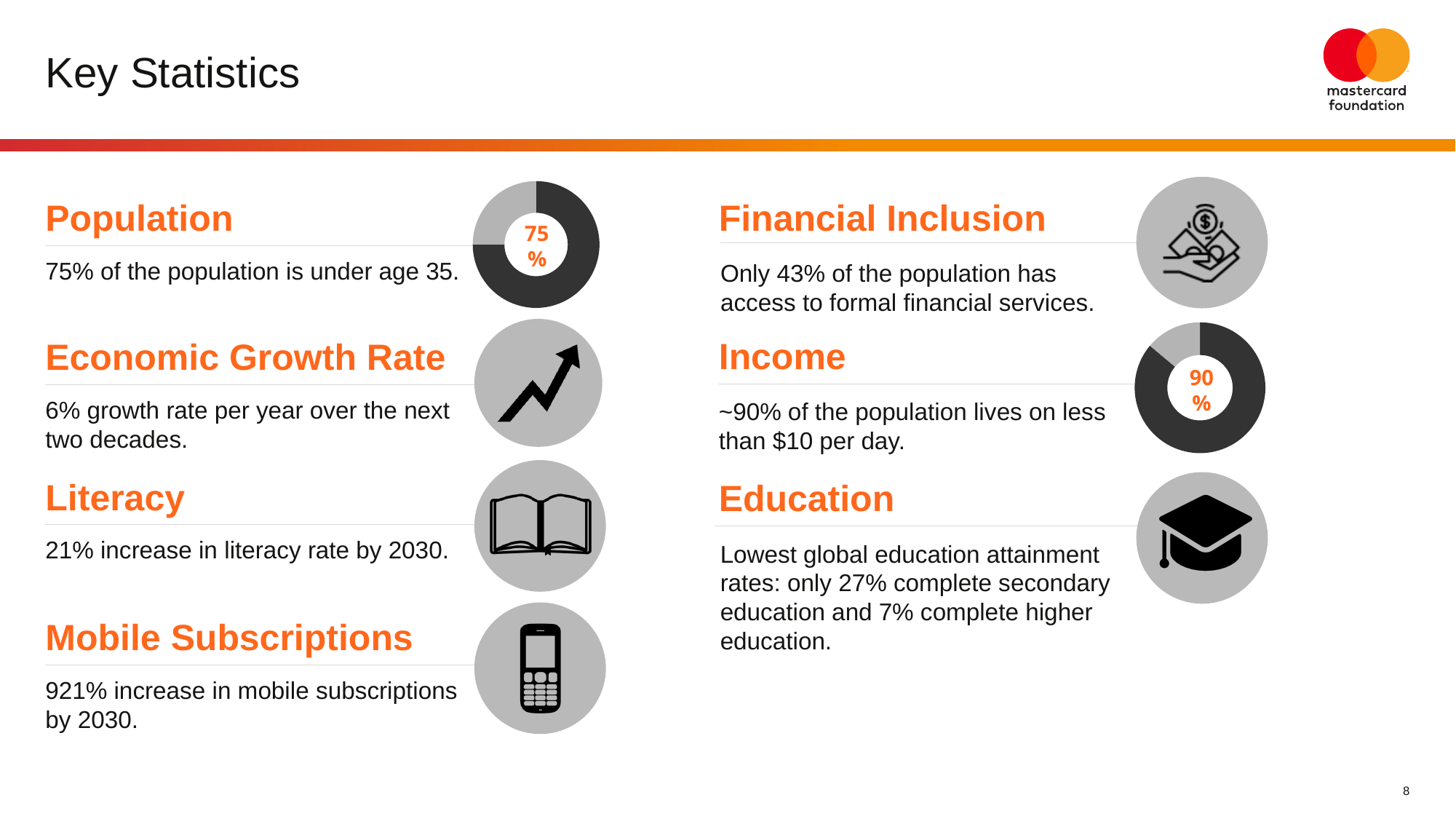
In the donut chart next to the Population heading, what value is printed in the centre? 75% What kind of chart is shown next to the Income heading? donut chart How many slices does the donut chart next to the Income heading have? 2 What kind of chart is shown next to the Population heading? donut chart In the donut chart next to the Income heading, what value is printed in the centre? 90% How many slices does the donut chart next to the Population heading have? 2 In the donut chart next to the Income heading, which slice is larger, the dark one or the light grey one? the dark one In the donut chart next to the Population heading, is the dark slice larger or smaller than the light grey slice? larger In the donut chart next to the Population heading, what share of the ring does the dark slice represent? 75% What colour is the text of the percentage printed in the centre of the donut charts? orange Which donut chart shows the larger percentage, the one next to Population or the one next to Income? Income